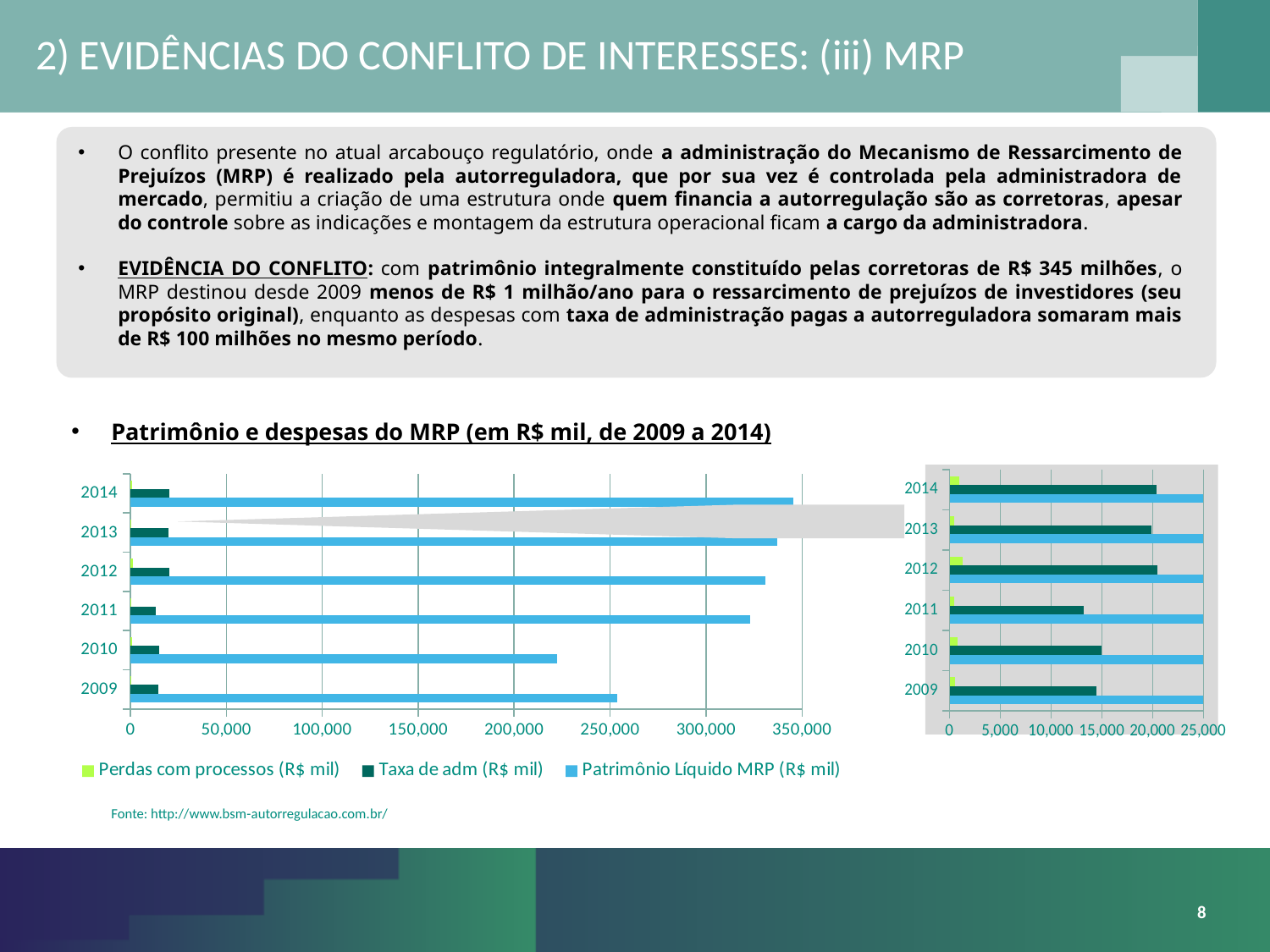
In the left chart, is the Patrimônio Líquido MRP (R$ mil) for 2010 greater or less than 250,000? less How many series does the legend of the left chart list? 3 In the right chart, is the Taxa de adm (R$ mil) for 2014 greater or less than 15,000? greater In the left chart, which is larger: the Patrimônio Líquido MRP (R$ mil) for 2011 or for 2010? 2011 In the left chart, is the Patrimônio Líquido MRP (R$ mil) for 2009 greater or less than 300,000? less What is the title given above the charts? Patrimônio e despesas do MRP (em R$ mil, de 2009 a 2014) What kind of chart is the left chart under 'Patrimônio e despesas do MRP'? bar chart In the left chart, which year has the lowest Patrimônio Líquido MRP (R$ mil)? 2010 In the left chart, which year has the highest Patrimônio Líquido MRP (R$ mil)? 2014 How many years are shown on the left chart? 6